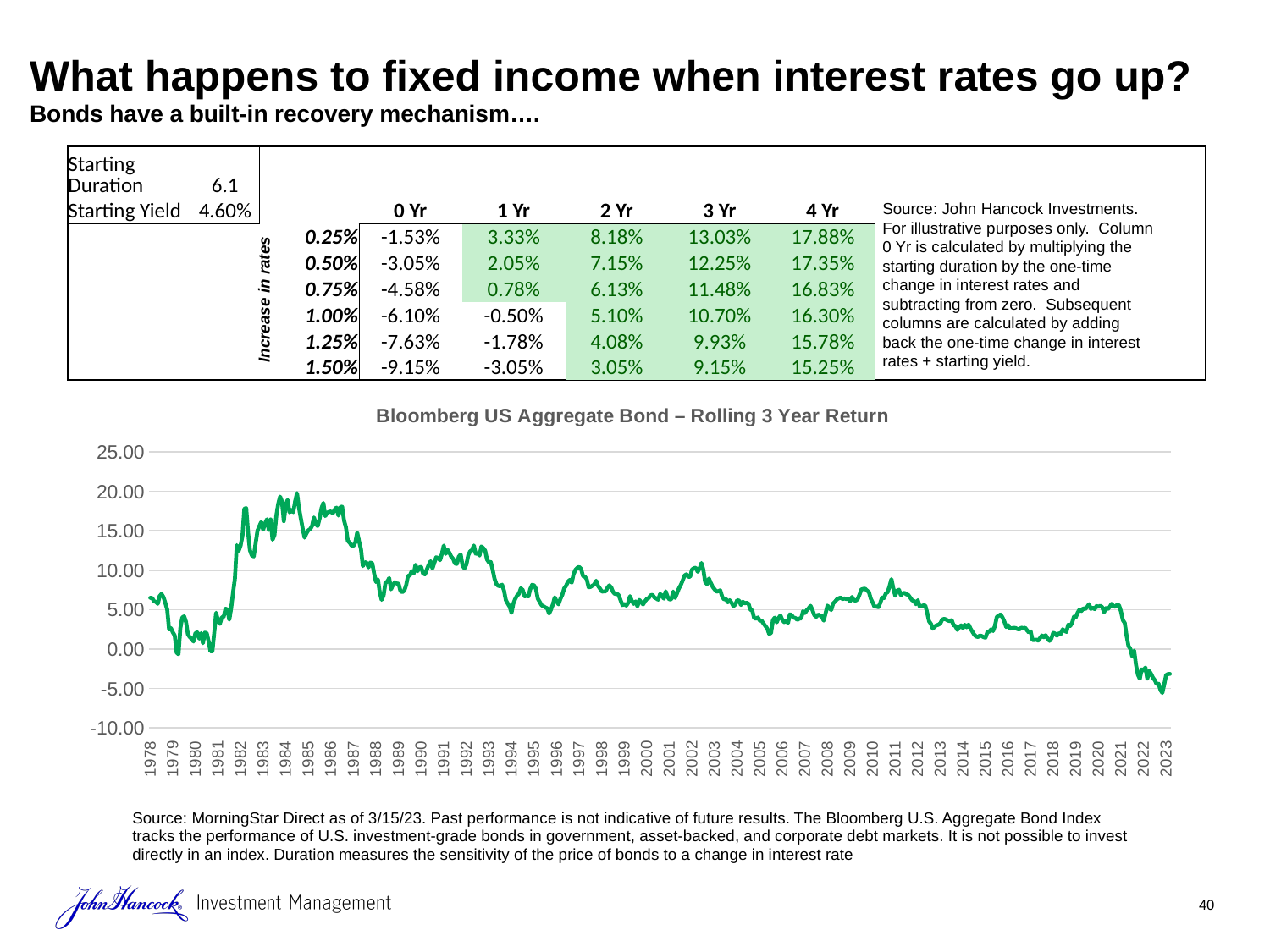
Is the value for 2016 greater or less than 5.00? less Is the value for 1988 greater or less than 5.00? greater Is the value for 2010 greater or less than 10.00? less What kind of chart is shown on the slide? line chart In which year does the line reach its lowest point? 2023 What is the first year shown on the x axis of the chart? 1978 What is the title of the chart on the slide? Bloomberg US Aggregate Bond – Rolling 3 Year Return Which is larger, the value for 1985 or the value for 2005? 1985 Does the rolling 3 year return generally rise or fall from 1985 to 2023? fall Which is larger, the value for 2019 or the value for 2022? 2019